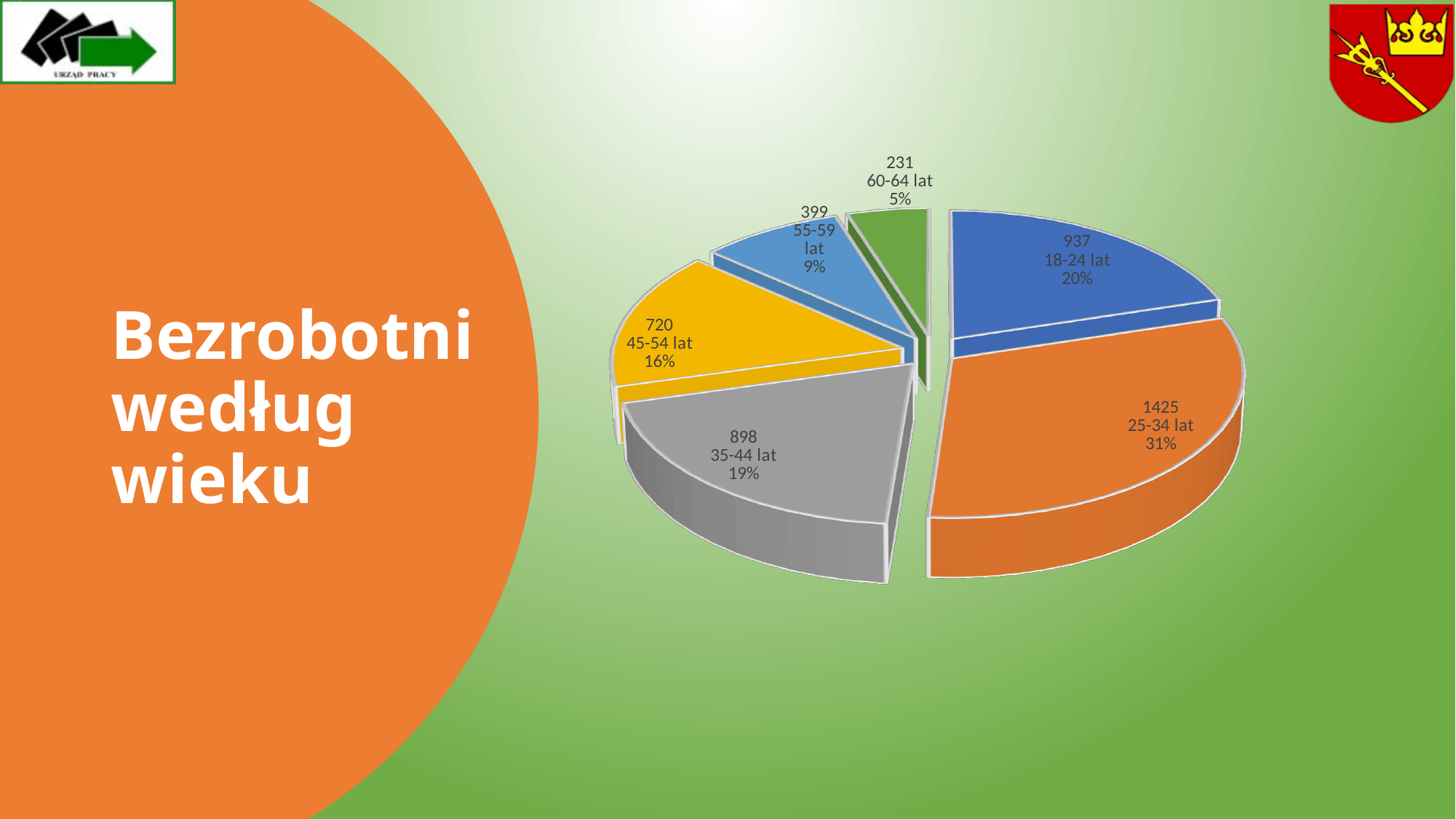
What is the value for the 25-34 lat age group? 1425 Which age group has the lowest value? 60-64 lat What is the title text shown on the slide next to the chart? Bezrobotni według wieku What is the value for the 55-59 lat age group? 399 What share of the pie does the 18-24 lat group represent? 20% Which age group has the highest value? 25-34 lat What is the difference between the values for 25-34 lat and 18-24 lat? 488 What is the difference between the values for 55-59 lat and 60-64 lat? 168 What kind of chart is shown on the slide? pie chart How many age groups are shown in the pie chart? 6 Which is larger, the value for 35-44 lat or the value for 45-54 lat? 35-44 lat What share of the pie does the 45-54 lat group represent? 16%